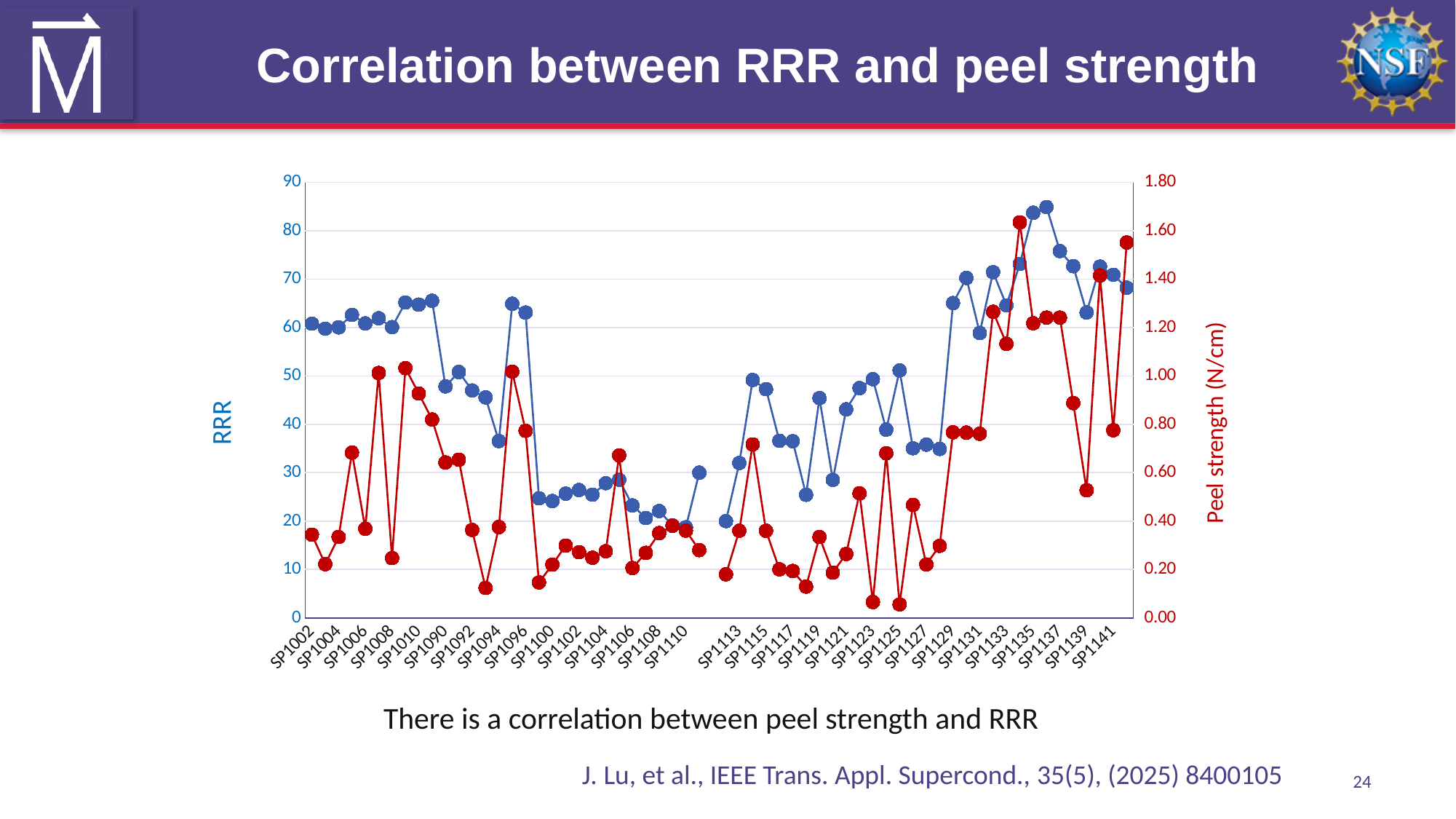
Which has the larger peel strength value, SP1002 or SP1141? SP1141 What kind of chart is shown on the slide? line chart What is the title of the left vertical axis? RRR Is the peel strength value for SP1123 greater or less than 0.20? less Is the RRR value for SP1100 greater or less than 40? less Is the RRR value for SP1002 greater or less than 50? greater Which has the larger RRR value, SP1002 or SP1100? SP1002 What is the title of the right vertical axis? Peel strength (N/cm) How many data series are plotted on the chart? 2